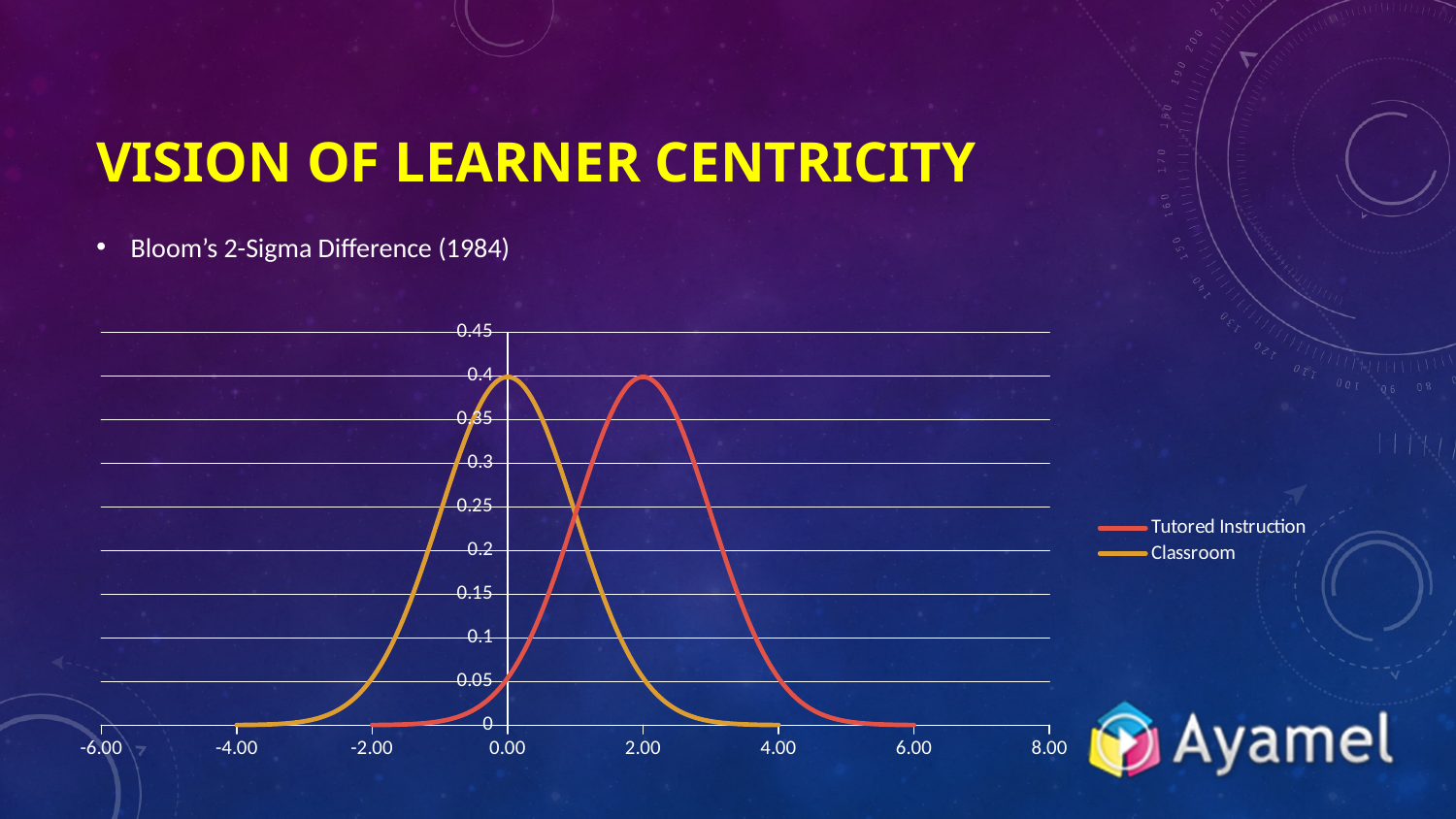
At x = 2.00, which series has the higher value, Tutored Instruction or Classroom? Tutored Instruction How many series does the chart's legend list? 2 What colour is the Tutored Instruction line? red At x = 0.00, which series has the higher value, Tutored Instruction or Classroom? Classroom What are the two series named in the chart's legend? Tutored Instruction and Classroom Is the value of the Classroom curve at x = 2.00 greater or less than 0.1? less Between x = 2.00 and x = 4.00, does the Tutored Instruction curve rise or fall? fall Is the peak value of the Classroom curve greater or less than 0.35? greater At which x-axis value does the Tutored Instruction curve reach its peak? 2.00 At which x-axis value does the Classroom curve reach its peak? 0.00 Is the peak value of the Tutored Instruction curve greater or less than 0.45? less What kind of chart is shown on the slide? line chart